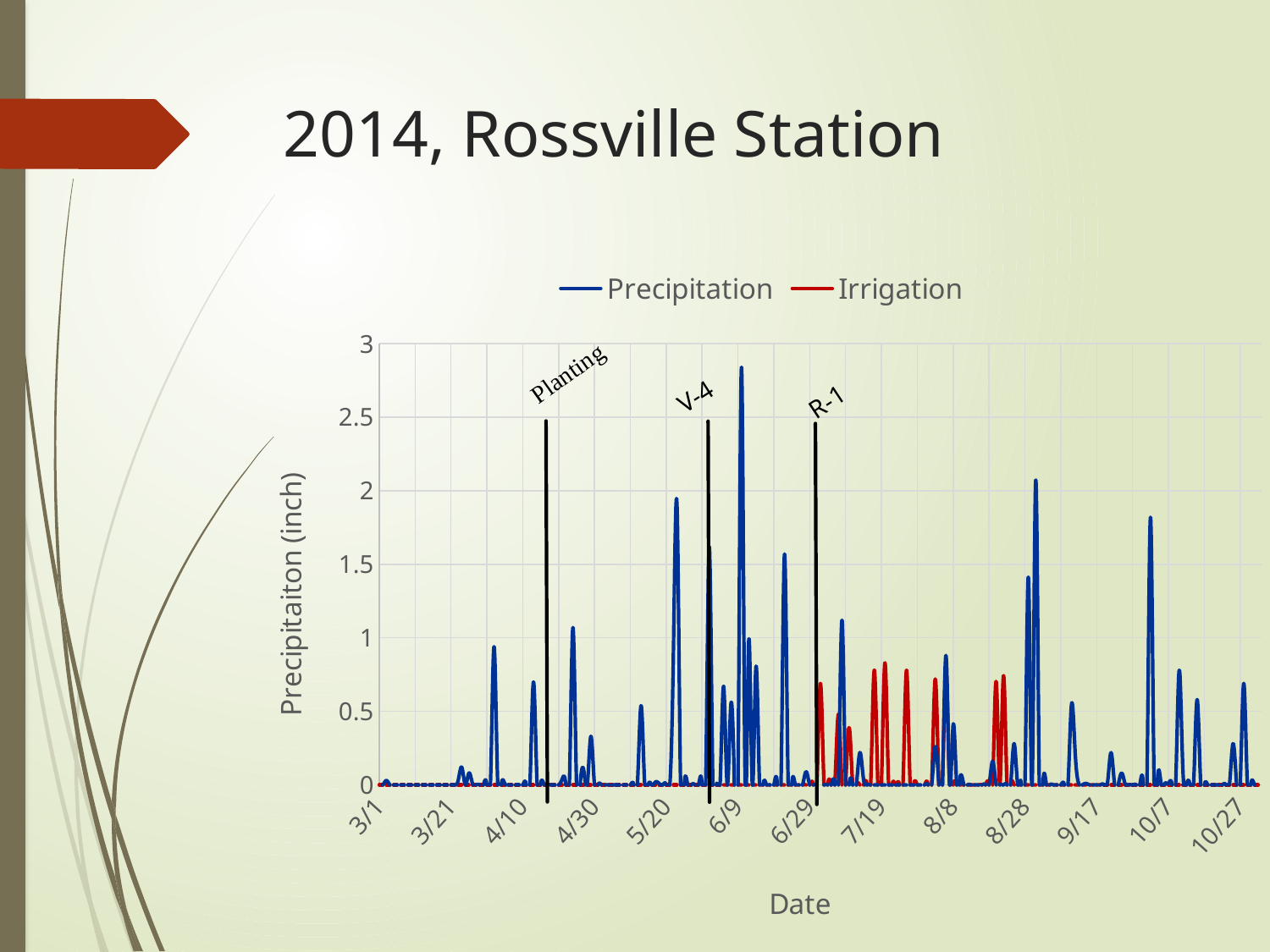
Which series is drawn in red? Irrigation Is the highest Precipitation value on the chart greater or less than 2.5? greater Is the highest Irrigation value on the chart greater or less than 1? less How many labelled vertical marker lines (Planting, V-4, R-1) are drawn on the chart? 3 How many series does the legend list? 2 What is the maximum value shown on the y axis? 3 Is the Precipitation peak just before 4/10 greater or less than 1? less What kind of chart is shown on the slide? line chart Which series reaches a higher peak value, Precipitation or Irrigation? Precipitation What is the title of the slide containing the chart? 2014, Rossville Station How many date labels are shown along the x axis? 13